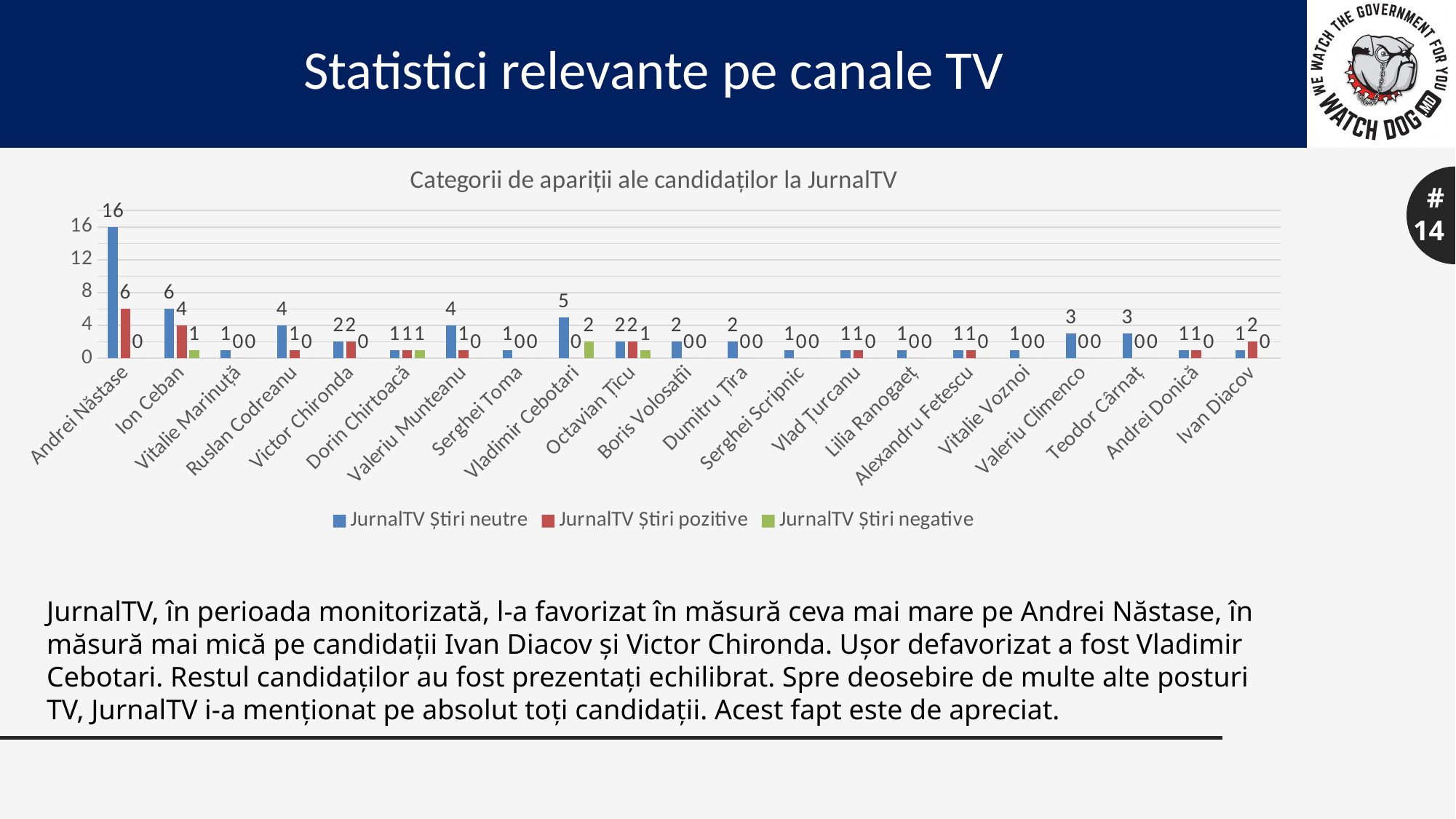
What kind of chart is shown on the slide? Bar chart What is the value of JurnalTV Știri pozitive for Ivan Diacov? 2 What is the value of JurnalTV Știri negative for Vladimir Cebotari? 2 What is the value of JurnalTV Știri pozitive for Ion Ceban? 4 What is the value of JurnalTV Știri neutre for Andrei Năstase? 16 What is the title of the chart? Categorii de apariții ale candidaților la JurnalTV How many candidates are shown on the x axis of the chart? 21 What is the difference between JurnalTV Știri neutre and JurnalTV Știri pozitive for Andrei Năstase? 10 Which colour represents JurnalTV Știri negative in the chart? Green Which is larger for Ion Ceban: JurnalTV Știri neutre or JurnalTV Știri pozitive? JurnalTV Știri neutre How many series does the legend list? 3 Which candidate has the highest value for JurnalTV Știri neutre? Andrei Năstase